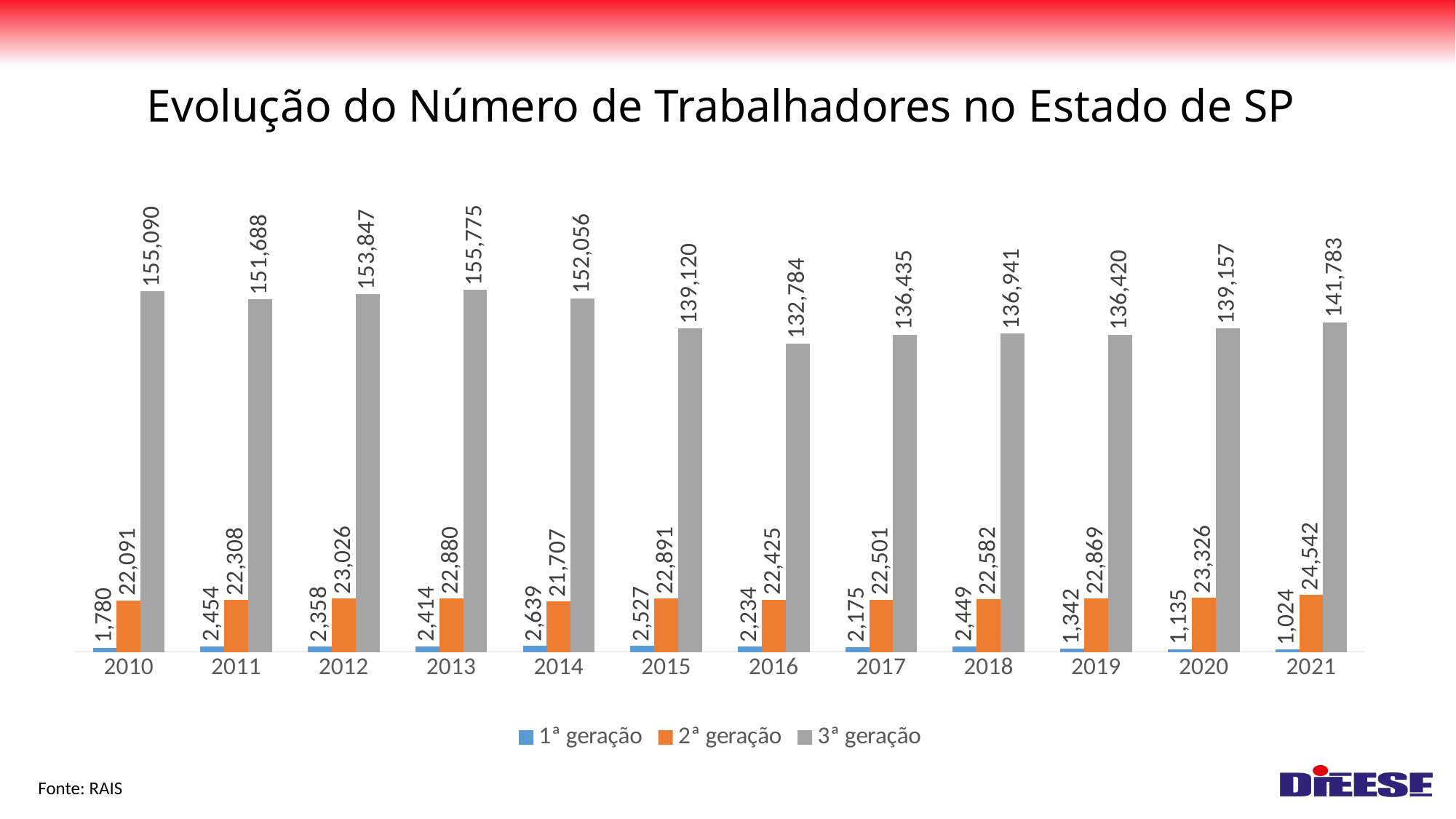
How many series does the legend list? 3 In which year is the 1ª geração value lowest? 2021 What is the value for 1ª geração in 2010? 1,780 What kind of chart is shown on the slide? Bar chart What is the difference between the 3ª geração values in 2010 and 2021? 13,307 In which year is the 3ª geração value highest? 2013 What is the title of the chart? Evolução do Número de Trabalhadores no Estado de SP What is the value for 2ª geração in 2021? 24,542 Which is larger, the 2ª geração value in 2012 or in 2014? 2012 How many years are shown on the x axis? 12 What is the value for 3ª geração in 2013? 155,775 In which year is the 3ª geração value lowest? 2016